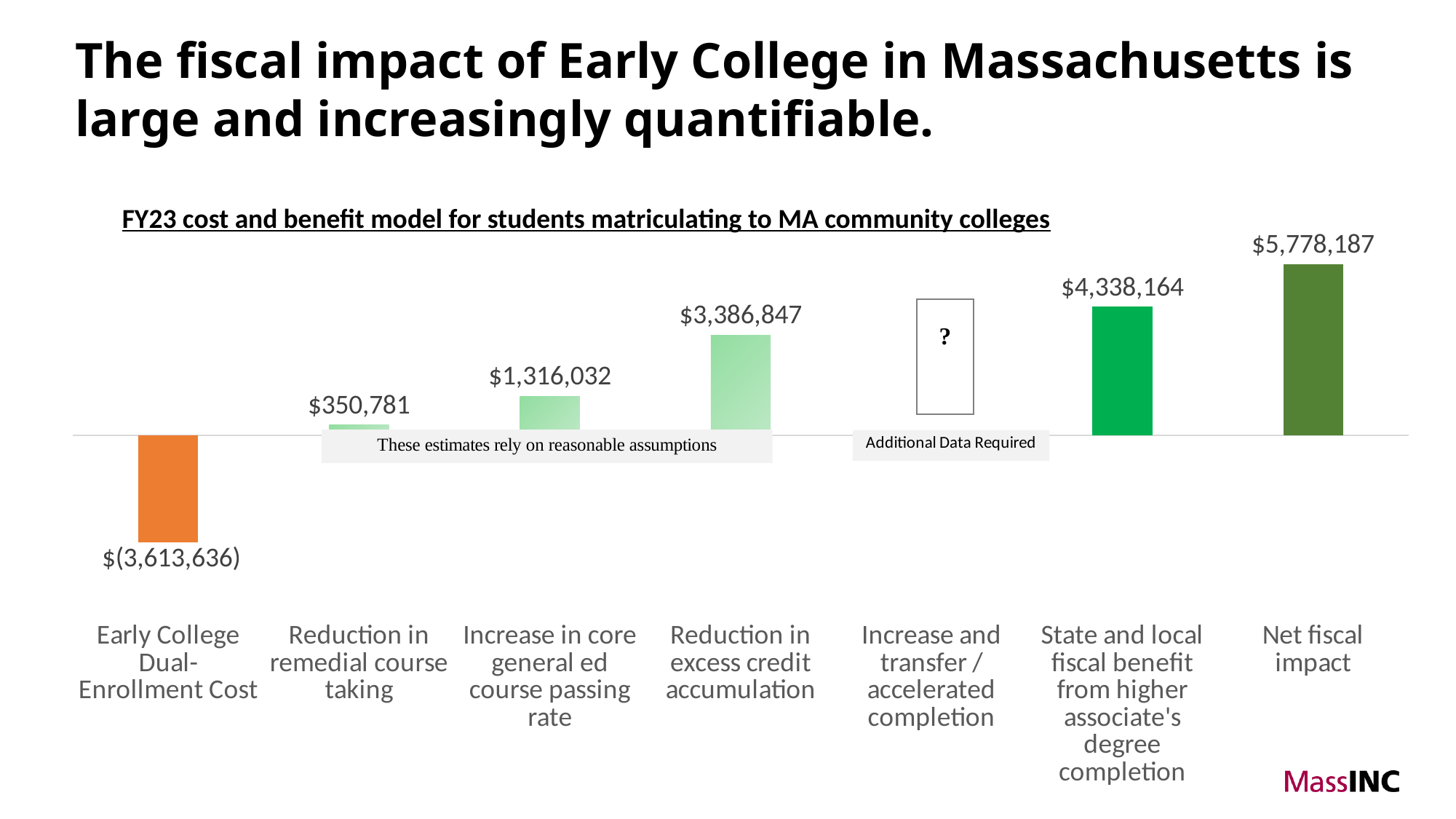
What is the value shown for Reduction in remedial course taking? $350,781 Which category is marked with a question mark instead of a value? Increase and transfer / accelerated completion What is the value shown for State and local fiscal benefit from higher associate's degree completion? $4,338,164 How many categories are shown along the x axis of the chart? 7 Which category has the highest value in the chart? Net fiscal impact Which is larger: the value for Increase in core general ed course passing rate or the value for Reduction in remedial course taking? Increase in core general ed course passing rate What is the value shown for Reduction in excess credit accumulation? $3,386,847 What kind of chart is shown on the slide? Bar chart What is the difference between the value for State and local fiscal benefit from higher associate's degree completion and the value for Reduction in excess credit accumulation? $951,317 Which category has the lowest value in the chart? Early College Dual-Enrollment Cost What is the value shown for Net fiscal impact? $5,778,187 What is the value shown for Early College Dual-Enrollment Cost? $(3,613,636)